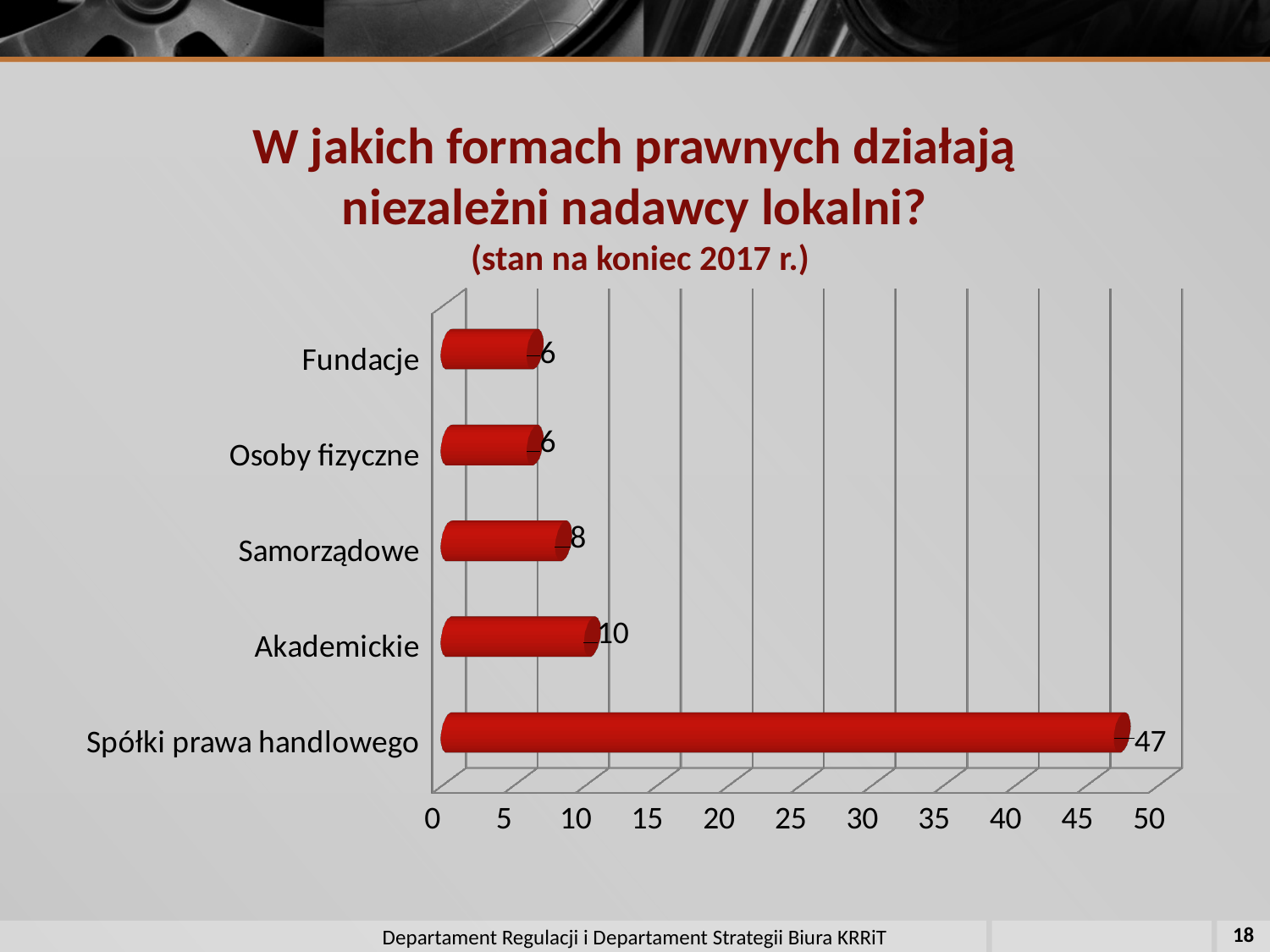
What is the value for Samorządowe? 8 What is the value for Spółki prawa handlowego? 47 What is the difference between the values for Akademickie and Samorządowe? 2 What is the value for Fundacje? 6 Which is larger, the value for Samorządowe or the value for Osoby fizyczne? Samorządowe Is the value for Spółki prawa handlowego greater or less than 45? greater What is the value for Akademickie? 10 What kind of chart is shown on the slide? bar chart What is the subtitle shown under the chart title? (stan na koniec 2017 r.) How many categories are shown in the chart? 5 Which category has the highest value? Spółki prawa handlowego What is the difference between the values for Spółki prawa handlowego and Akademickie? 37